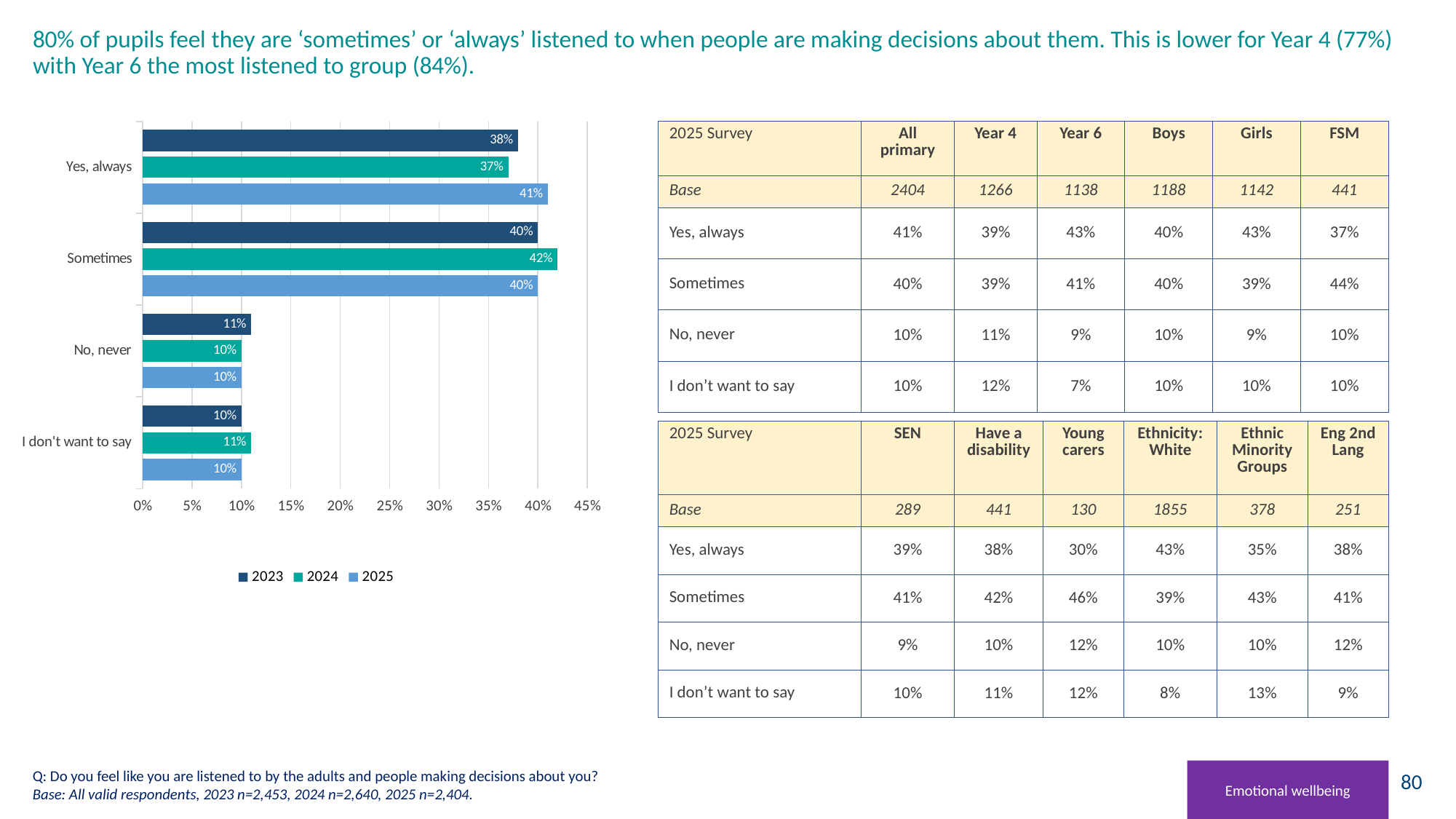
Which category has the lowest 2024 value in the chart? No, never Is the 2023 value for 'Yes, always' greater or less than 35%? greater What is the difference between the 2025 and 2024 values for 'Yes, always'? 4% How many response categories are shown on the chart? 4 What is the 2023 value for 'No, never' in the chart? 11% What is the 2025 value for 'Yes, always' in the chart? 41% How many series does the chart legend list? 3 What kind of chart is shown on the slide? bar chart Which years are listed in the chart legend? 2023, 2024, 2025 Which is larger for 'Sometimes': the 2023 value or the 2024 value? 2024 What is the 2024 value for 'Sometimes' in the chart? 42% Which category has the highest 2025 value in the chart? Yes, always